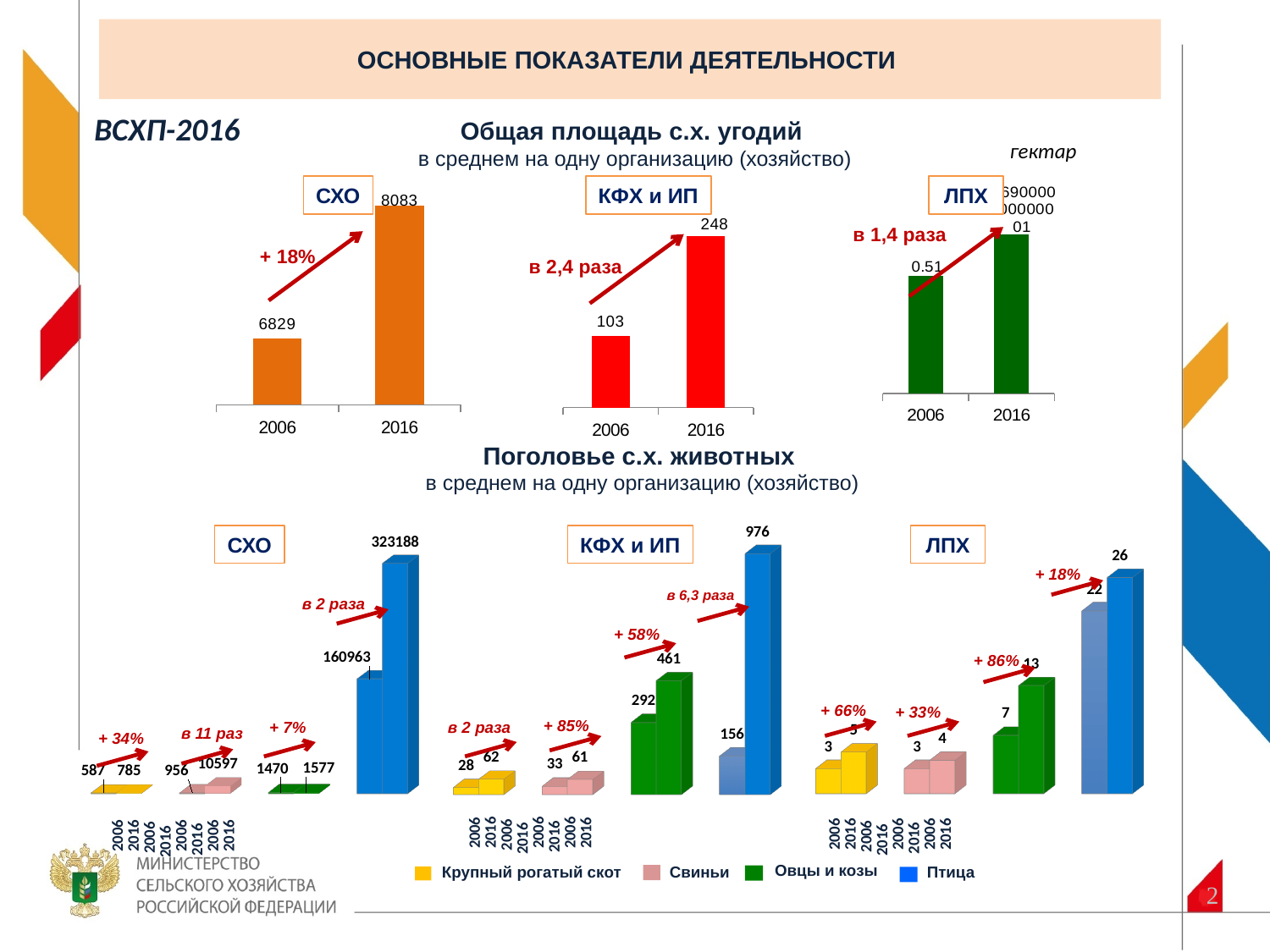
In the top-row 'Общая площадь с.х. угодий' chart for ЛПХ, what is the value for 2006? 0.51 In the bottom-row 'Поголовье с.х. животных' chart for СХО, what is the value for Свиньи in 2016? 10597 In the top-row 'Общая площадь с.х. угодий' chart for СХО, what is the value for 2016? 8083 How many series does the legend of the bottom-row 'Поголовье с.х. животных' charts list? 4 In the bottom-row 'Поголовье с.х. животных' chart for ЛПХ, what is the difference between the 2016 and 2006 values for Овцы и козы? 6 In the top-row 'Общая площадь с.х. угодий' chart for СХО, what is the difference between the 2016 and 2006 values? 1254 In the bottom-row 'Поголовье с.х. животных' chart for КФХ и ИП, what is the value for Овцы и козы in 2006? 292 In the top-row 'Общая площадь с.х. угодий' chart for КФХ и ИП, what is the value for 2016? 248 In the top-row 'Общая площадь с.х. угодий' chart for СХО, what is the value for 2006? 6829 In the bottom-row 'Поголовье с.х. животных' chart for СХО, what is the value for Птица in 2016? 323188 In the bottom-row 'Поголовье с.х. животных' chart for КФХ и ИП, which series has the highest value in 2016? Птица In the top-row 'Общая площадь с.х. угодий' chart for КФХ и ИП, what is the value for 2006? 103